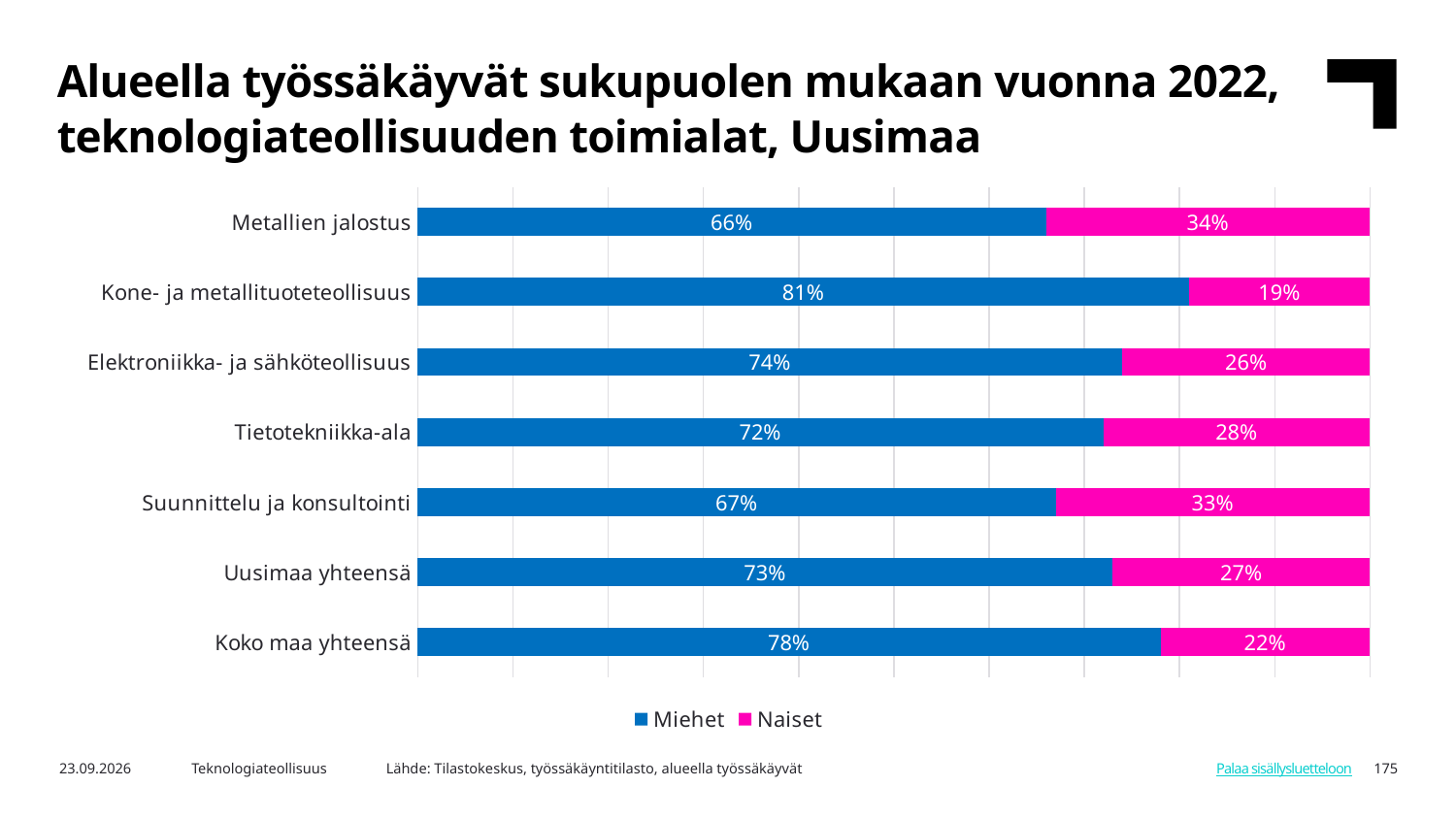
What is the total of the stacked bar for Tietotekniikka-ala? 100% How many categories are shown on the chart? 7 What is the difference between the Miehet and Naiset shares for Suunnittelu ja konsultointi? 34 percentage points What kind of chart is shown on the slide? Stacked bar chart Which category has the highest Miehet share? Kone- ja metallituoteteollisuus What is the Naiset share for Tietotekniikka-ala? 28% How many series does the legend list? 2 Which category has the lowest Miehet share? Metallien jalostus What is the Miehet share for Metallien jalostus? 66% Which is larger: the Naiset share for Elektroniikka- ja sähköteollisuus or for Uusimaa yhteensä? Uusimaa yhteensä What is the Miehet share for Koko maa yhteensä? 78% What is the Naiset share for Kone- ja metallituoteteollisuus? 19%